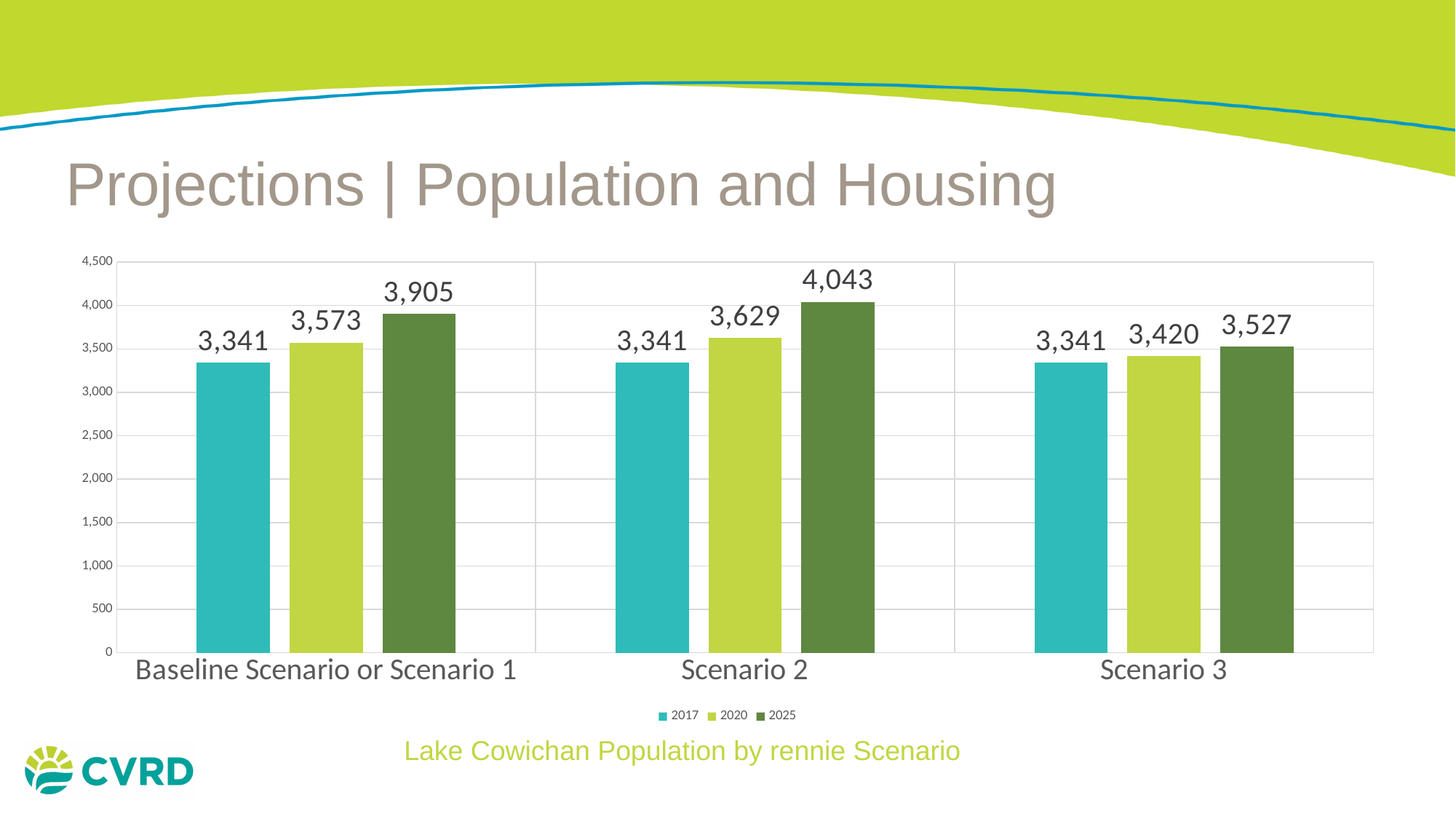
What kind of chart is shown on the slide? Bar chart What is the 2020 value for Scenario 3? 3,420 Which scenario has the lowest 2020 value? Scenario 3 How many scenarios are shown on the x axis? 3 Which scenario has the highest 2025 value? Scenario 2 What is the 2025 value for Scenario 2? 4,043 What is the 2025 value for Baseline Scenario or Scenario 1? 3,905 What is the difference between the 2025 and 2017 values for Scenario 2? 702 Is the 2025 value for Scenario 2 greater or less than 4,000? greater How many series does the legend list? 3 What is the difference between the 2025 values for Baseline Scenario or Scenario 1 and Scenario 3? 378 Which is larger, the 2020 value for Scenario 2 or the 2020 value for Baseline Scenario or Scenario 1? Scenario 2